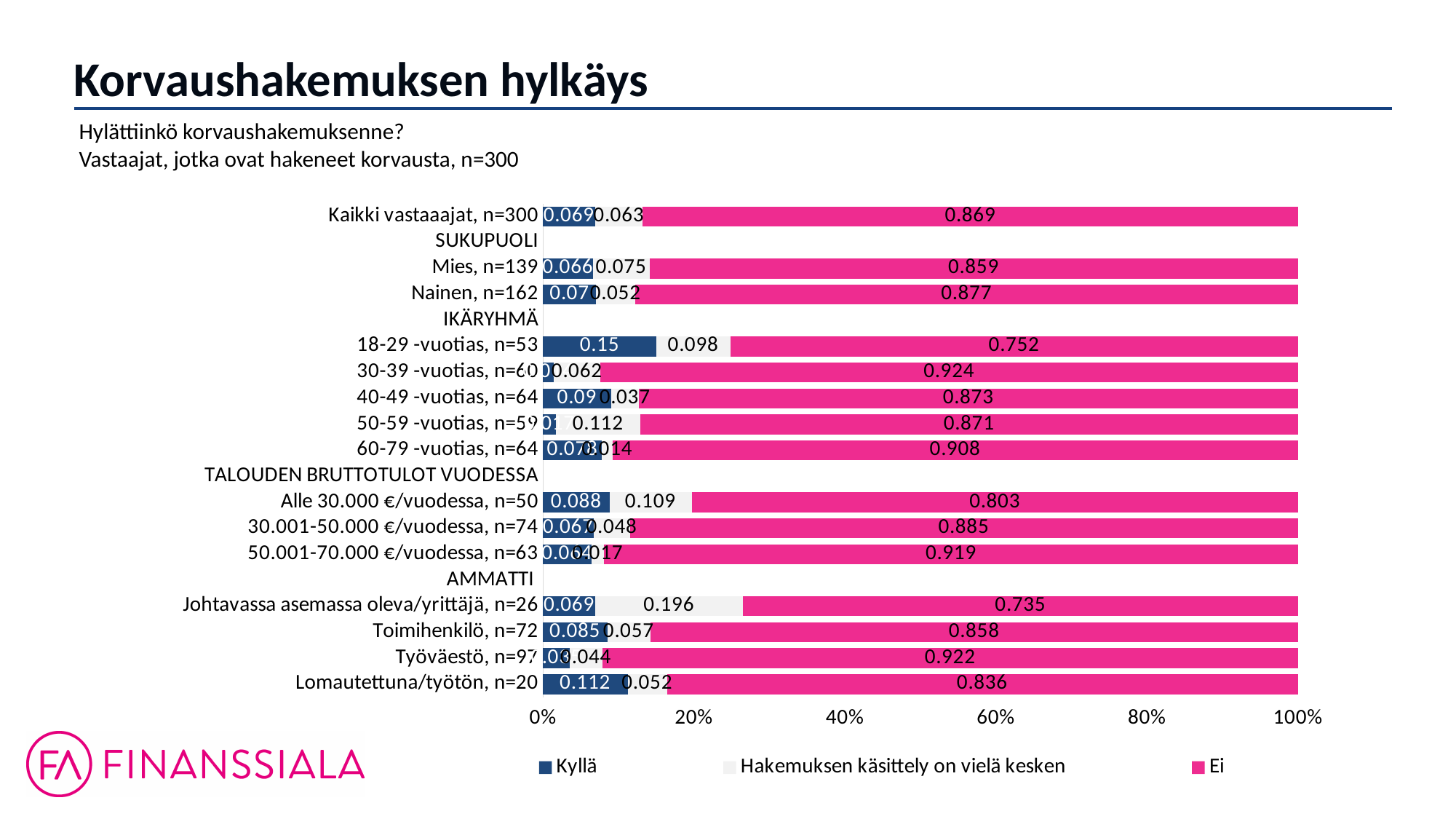
What is the difference between the 'Ei' values for 'Kaikki vastaaajat, n=300' and '18-29 -vuotias, n=53'? 0.117 Which has a larger 'Ei' value: 'Mies, n=139' or 'Nainen, n=162'? Nainen, n=162 What is the value of the 'Kyllä' series for '18-29 -vuotias, n=53'? 0.15 How many series does the legend list? 3 What is the value of the 'Ei' series for 'Lomautettuna/työtön, n=20'? 0.836 What is the value of 'Hakemuksen käsittely on vielä kesken' for 'Johtavassa asemassa oleva/yrittäjä, n=26'? 0.196 Which series is shown in pink in the chart? Ei Which category has the lowest 'Ei' value? Johtavassa asemassa oleva/yrittäjä, n=26 What kind of chart is shown on the slide? Stacked horizontal bar chart Is the 'Ei' value for 'Johtavassa asemassa oleva/yrittäjä, n=26' greater or less than 80%? less Which category has the highest 'Kyllä' value? 18-29 -vuotias, n=53 What is the value of the 'Ei' series for 'Kaikki vastaaajat, n=300'? 0.869